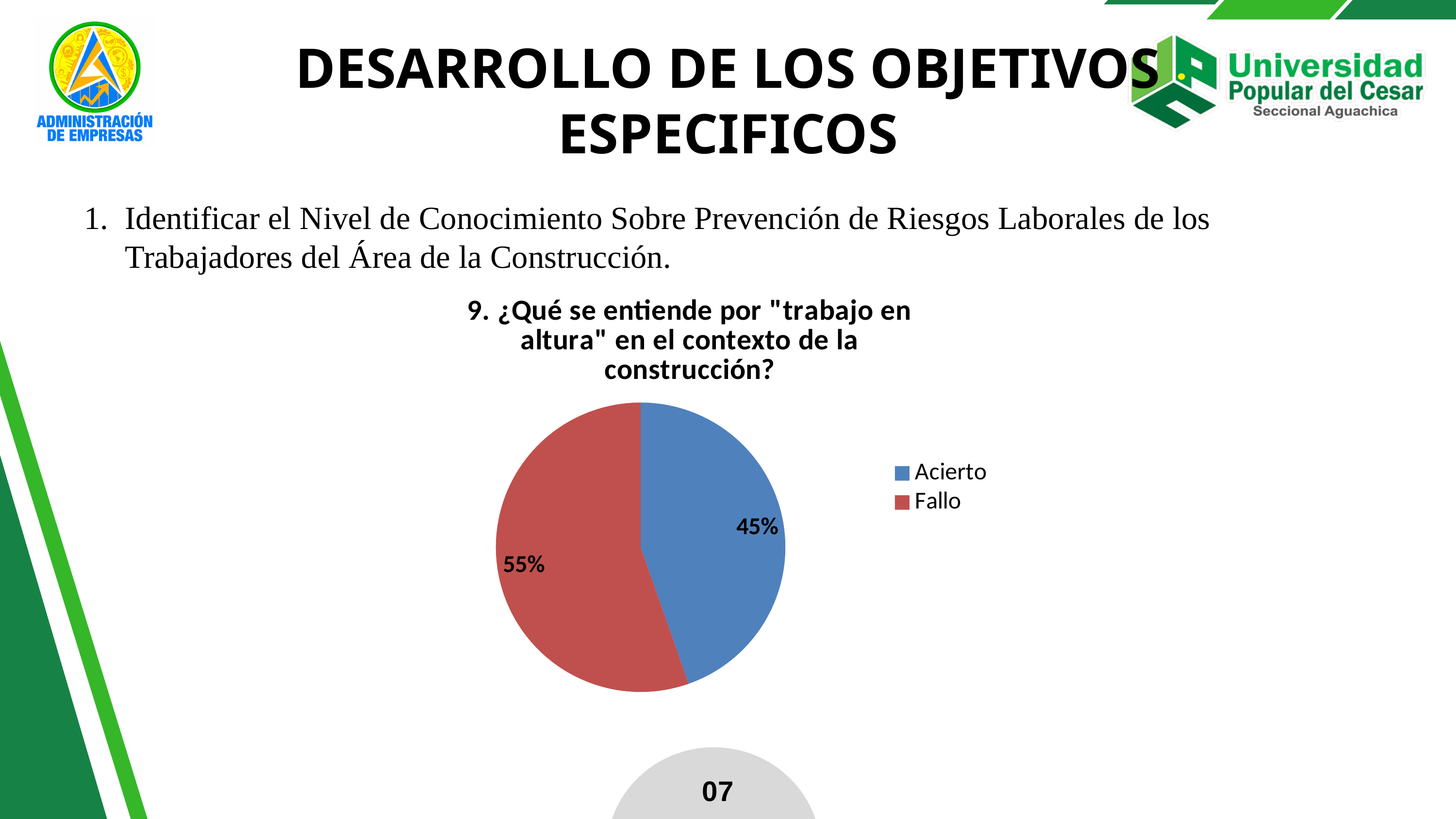
How many entries does the chart legend list? 2 What share of the pie does the Acierto slice represent? 45% What percentage of the pie chart corresponds to Acierto? 45% What is the difference in percentage points between Fallo and Acierto? 10 What colour is the Fallo slice in the pie chart? Red How many categories does the pie chart show? 2 Which is larger, the share for Acierto or the share for Fallo? Fallo What percentage of the pie chart corresponds to Fallo? 55% Which category has the largest share of the pie chart? Fallo What is the title of the pie chart? 9. ¿Qué se entiende por "trabajo en altura" en el contexto de la construcción? What type of chart is shown on the slide? Pie chart Which category has the smallest share of the pie chart? Acierto